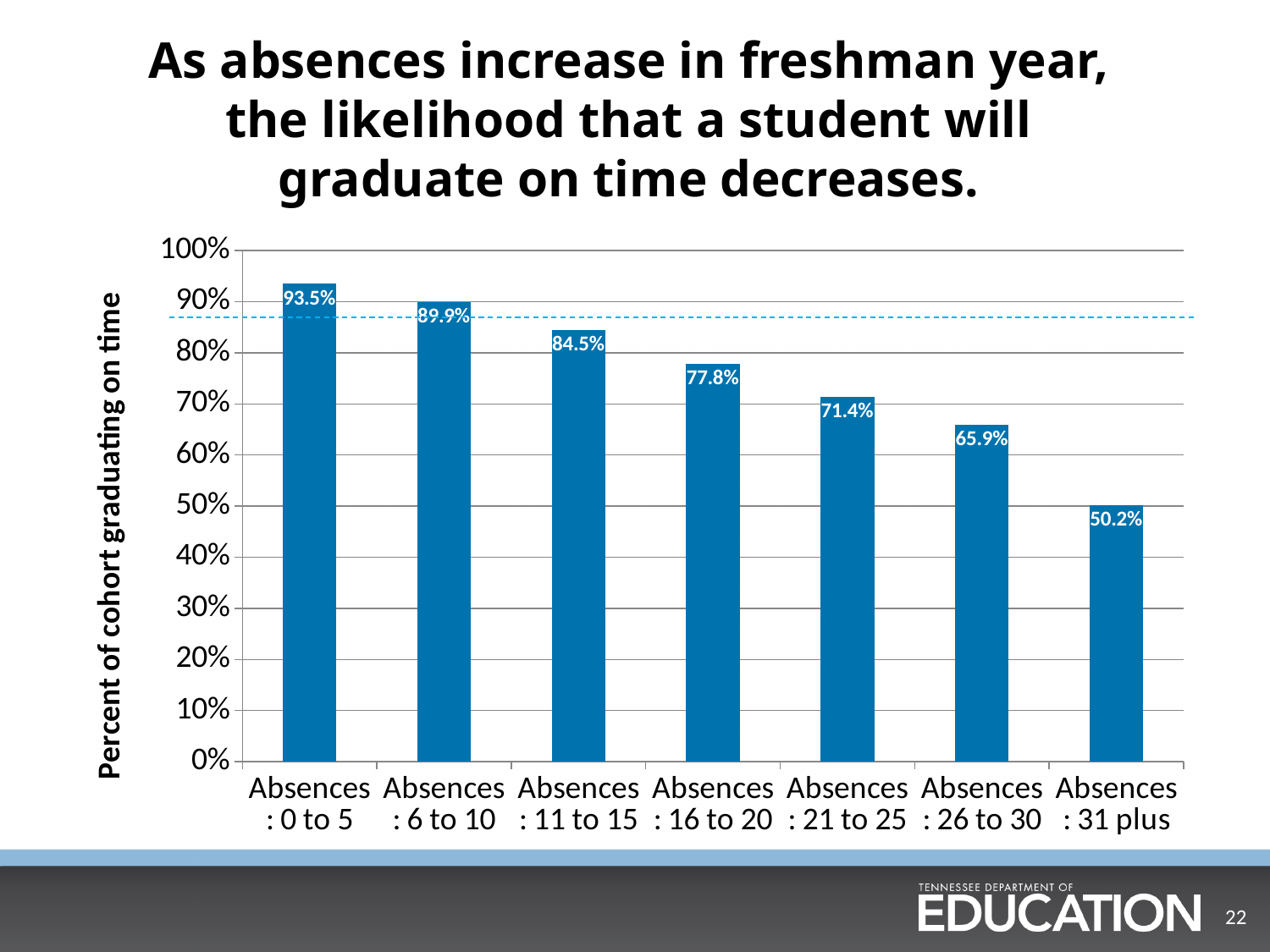
Which absence category has the lowest percent of cohort graduating on time? Absences: 31 plus Which absence category has the highest percent of cohort graduating on time? Absences: 0 to 5 What kind of chart is shown on the slide? bar chart How many absence categories are shown on the chart? 7 What is the difference between the 6 to 10 absences group and the 11 to 15 absences group? 5.4% Do the values rise or fall as absences increase along the x axis? fall What is the difference in on-time graduation rate between the 0 to 5 absences group and the 31 plus absences group? 43.3% What percent of the cohort with 0 to 5 absences graduated on time? 93.5% What is the value shown for the 31 plus absences category? 50.2% Is the value for 26 to 30 absences greater or less than 70%? less What is the on-time graduation rate for students with 16 to 20 absences? 77.8% Which has a higher on-time graduation rate: 21 to 25 absences or 26 to 30 absences? Absences: 21 to 25